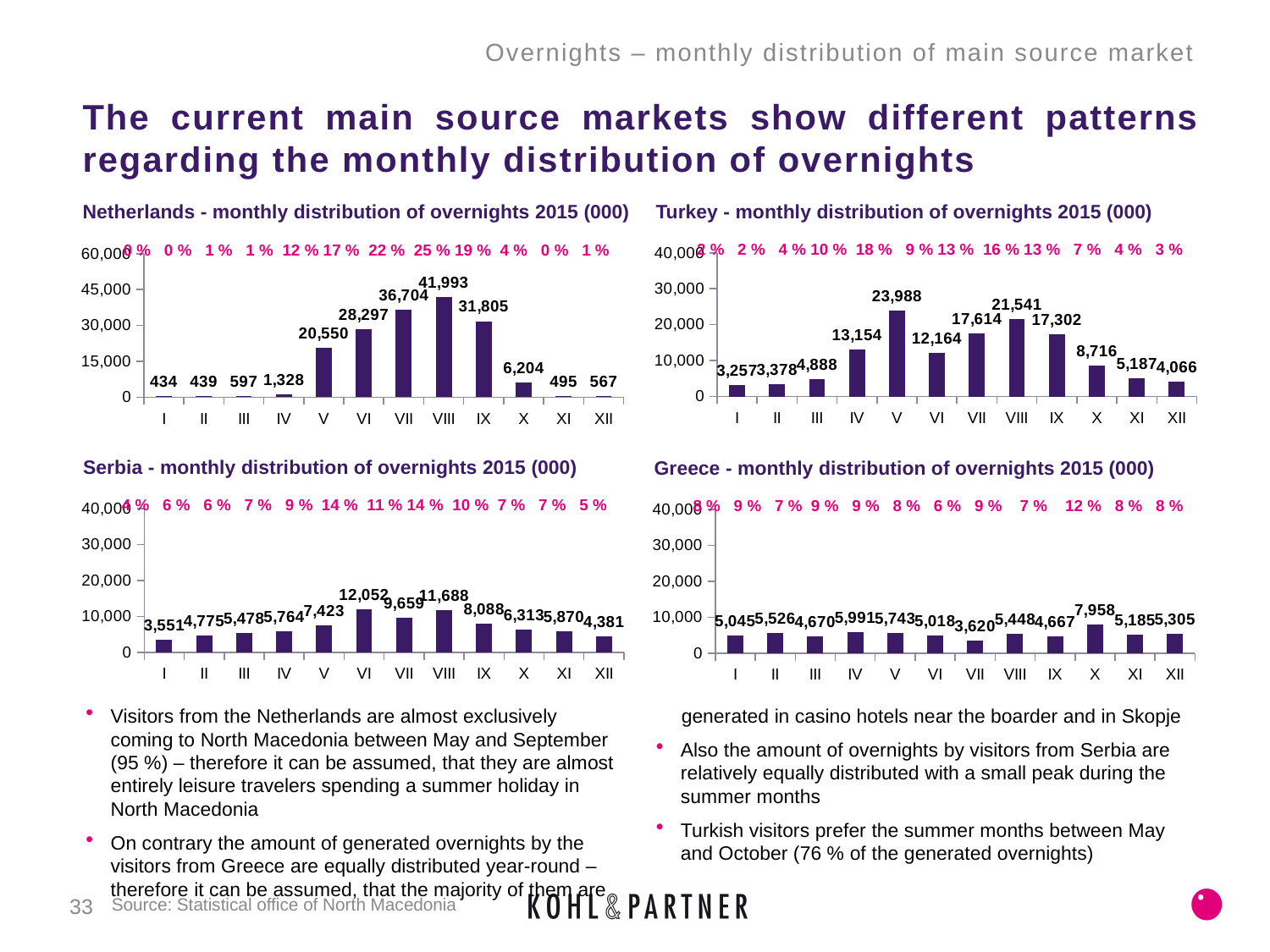
In the Turkey chart, which month has the highest value? V In the Netherlands chart, do the values rise or fall from month V to month VIII? rise What kind of chart is the Greece chart? bar chart How many months are shown on the x axis of the Serbia chart? 12 In the Greece chart, which month has the lowest value? VII In the Turkey chart, what is the value for month V? 23,988 In the Greece chart, what is the value for month X? 7,958 In the Serbia chart, which is larger, the value for month VI or month VIII? VI In the Serbia chart, which month has the lowest value? I In the Netherlands chart, what is the value for month VIII? 41,993 In the Turkey chart, is the value for month VIII greater or less than 20,000? greater In the Netherlands chart, what is the difference between the values for month VIII and month VII? 5,289